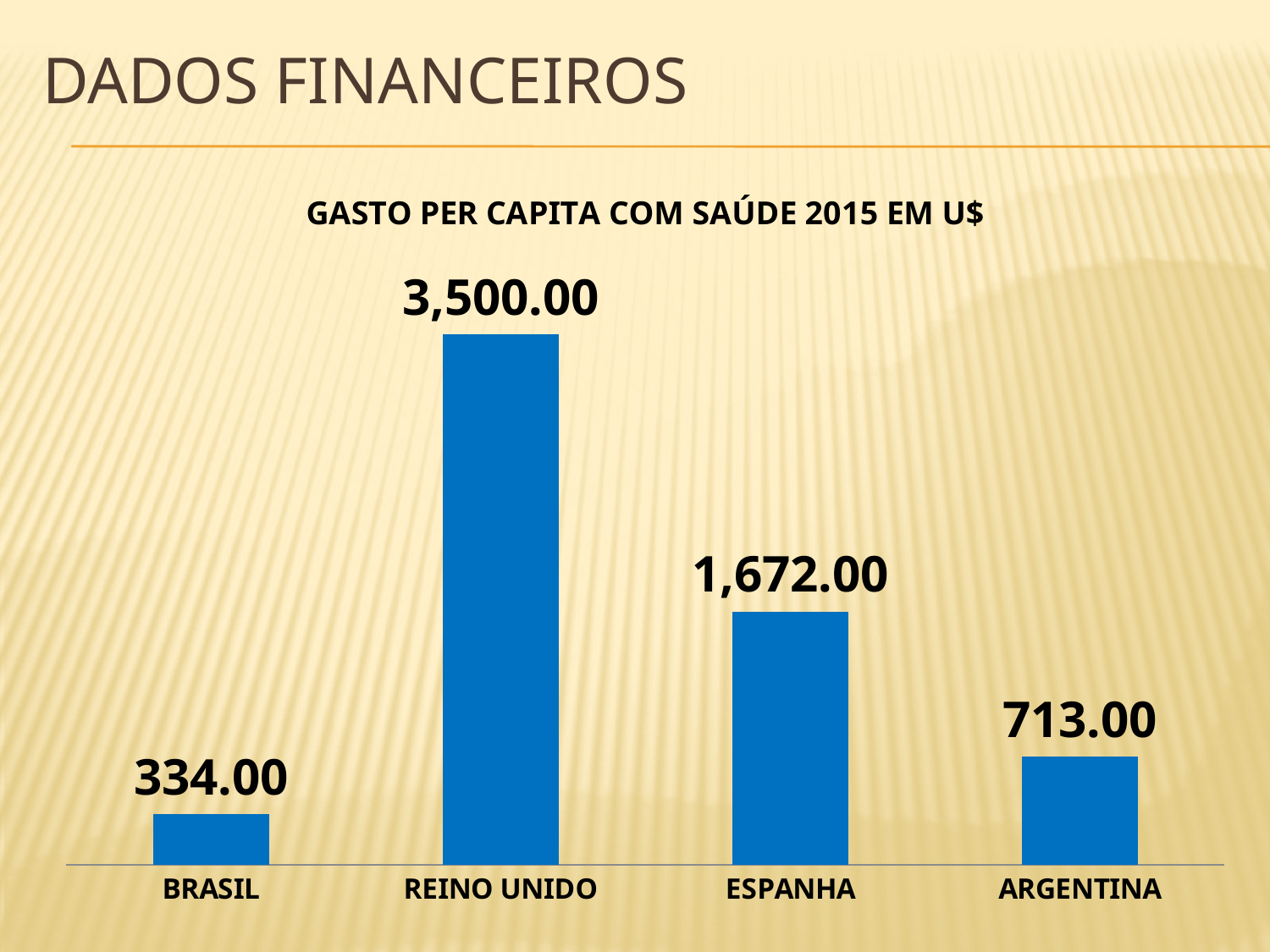
What is the difference between the values for ARGENTINA and BRASIL? 379.00 What is the value for ESPANHA? 1,672.00 Which country has the highest per capita health spending? REINO UNIDO What is the title of the chart? GASTO PER CAPITA COM SAÚDE 2015 EM U$ What kind of chart is shown on the slide? Bar chart What is the difference between the values for REINO UNIDO and ESPANHA? 1,828.00 What is the value for BRASIL? 334.00 What is the value for ARGENTINA? 713.00 How many countries are shown in the chart? 4 What is the value for REINO UNIDO? 3,500.00 Which country has the lowest per capita health spending? BRASIL Which is larger, the value for ESPANHA or the value for ARGENTINA? ESPANHA